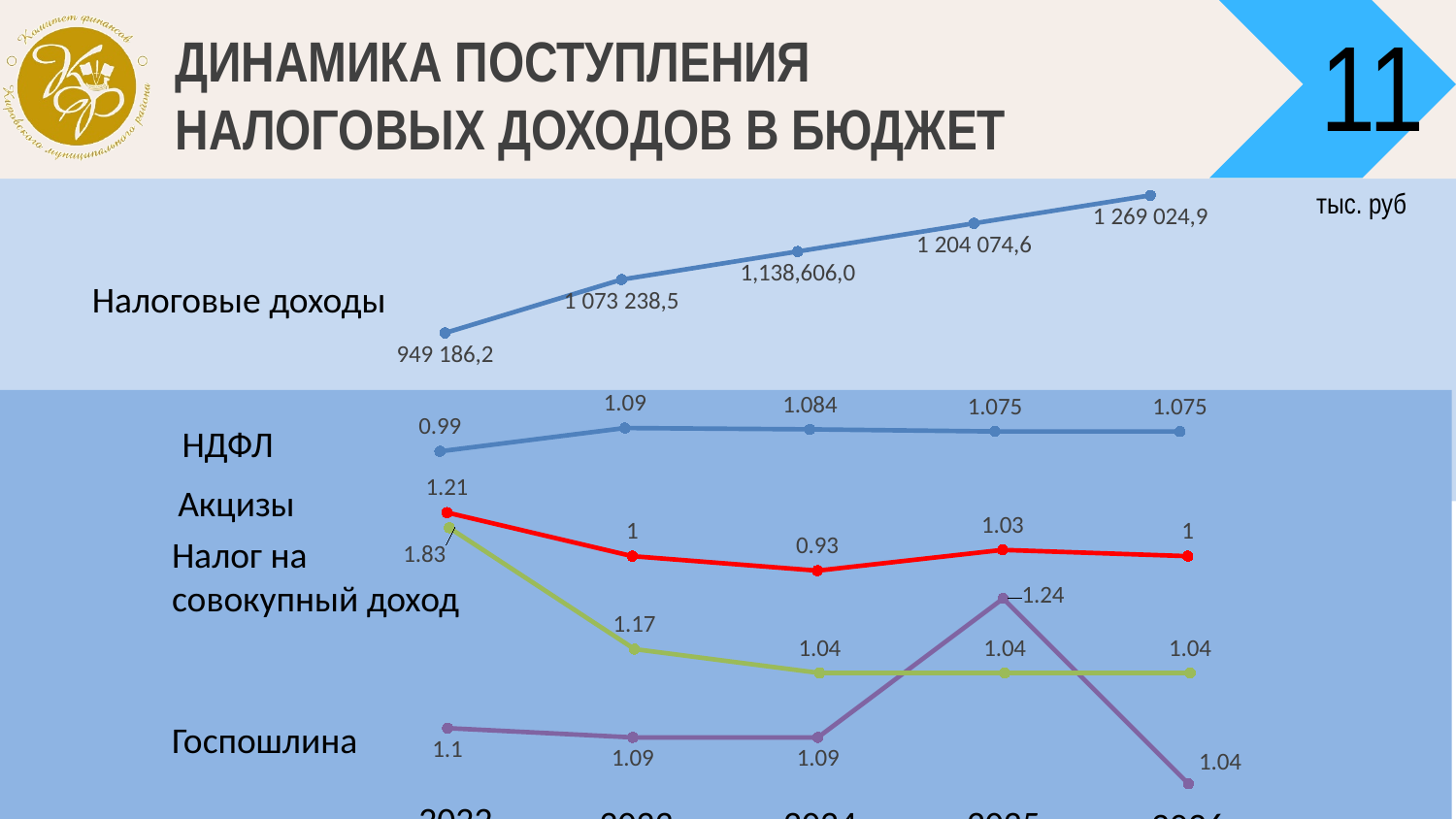
On the bottom chart, what is the first (leftmost) value of the НДФЛ series? 0.99 How many data points are plotted on the top chart (Налоговые доходы)? 5 On the top chart (Налоговые доходы), what is the value of the first (leftmost) point? 949 186,2 On the bottom chart, at the first (leftmost) point, which is larger: Акцизы or НДФЛ? Акцизы How many series are plotted on the bottom chart? 4 On the top chart (Налоговые доходы), what is the value of the last (rightmost) point? 1 269 024,9 On the bottom chart, what is the highest value of the Налог на совокупный доход series? 1.83 What unit is shown for the top chart (Налоговые доходы)? тыс. руб On the bottom chart, what is the lowest value of the Акцизы series? 0.93 On the bottom chart, what is the highest value of the Госпошлина series? 1.24 On the top chart (Налоговые доходы), do the values rise or fall from left to right? rise What kind of chart is the top chart (Налоговые доходы)? line chart